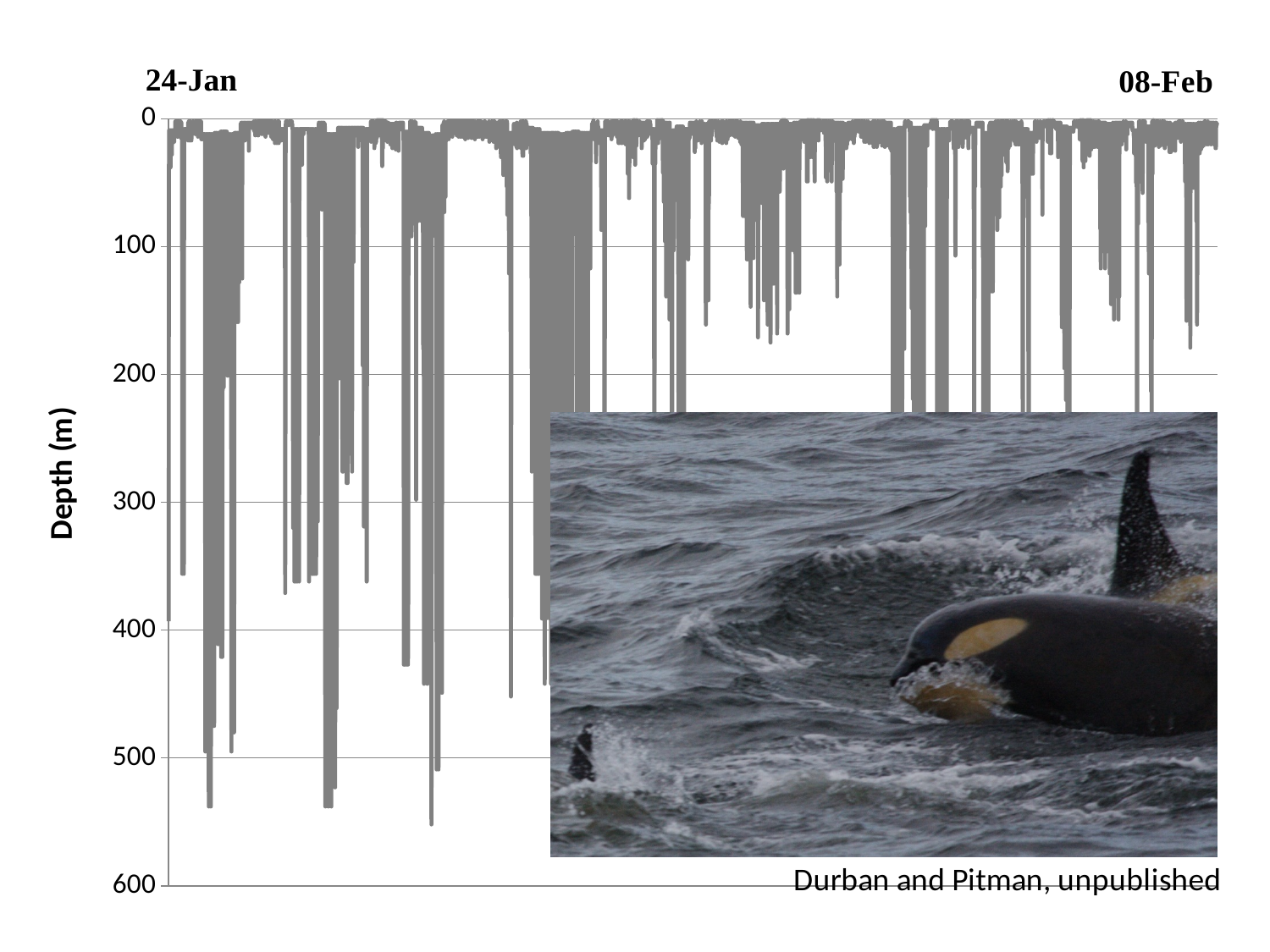
What kind of chart is shown on the slide? area chart Is the deepest dive shown on the chart greater or less than 400 m? greater What is the maximum depth value shown on the vertical axis? 600 Is the deepest dive shown on the chart greater or less than 600 m? less What date is shown at the left end of the chart's time axis? 24-Jan What is the label on the vertical axis of the chart? Depth (m) Is the deepest dive shown on the chart greater or less than 500 m? greater What date is shown at the right end of the chart's time axis? 08-Feb Who is credited as the source of the data on the slide? Durban and Pitman, unpublished What is the interval between the gridlines on the depth axis? 100